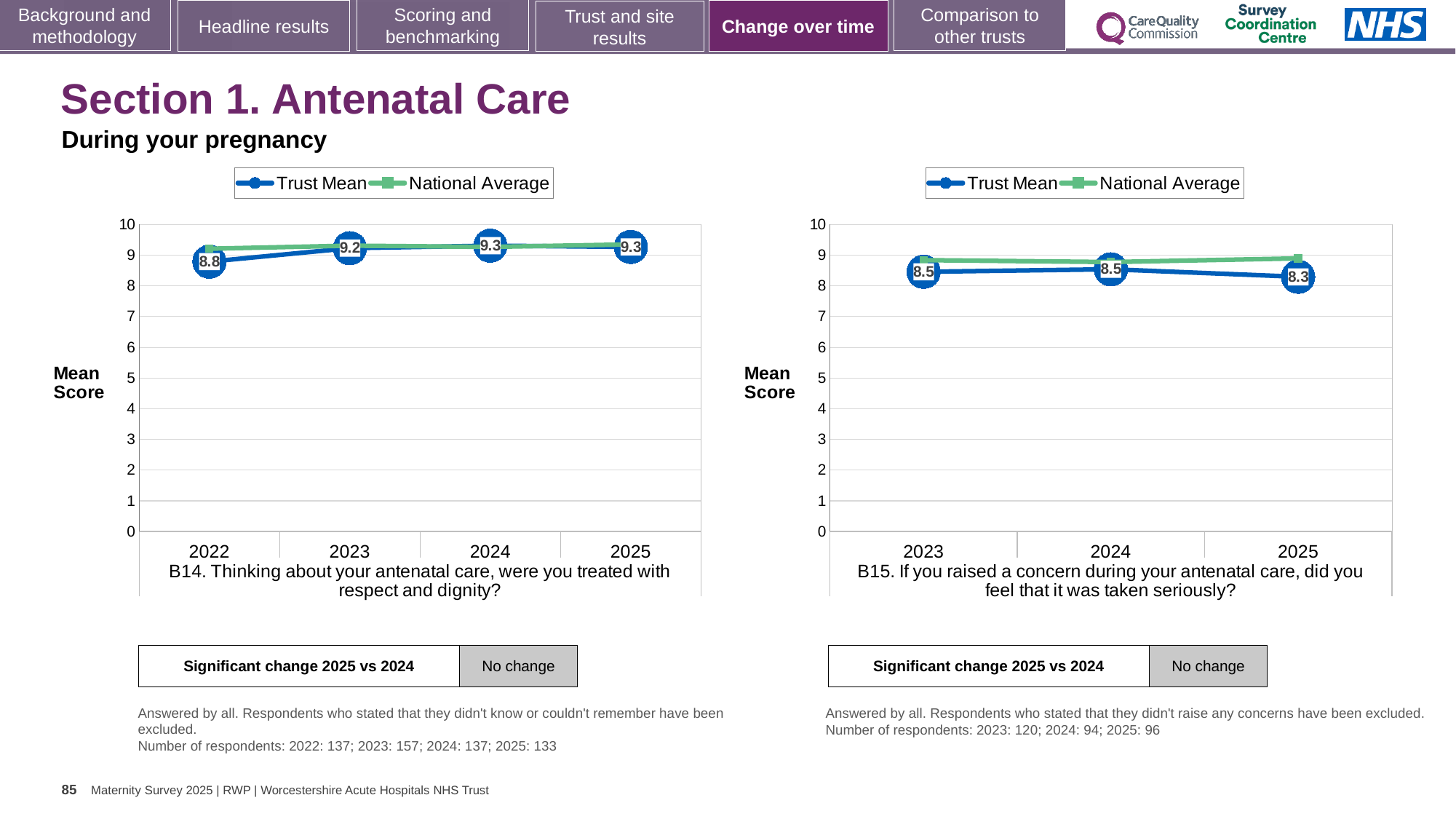
In the B14 chart (left), what is the Trust Mean for 2022? 8.8 In the B14 chart (left), what is the Trust Mean for 2025? 9.3 What kind of chart is the B14 chart (left)? Line chart In the B15 chart (right), is the Trust Mean for 2025 greater or less than 9? less In the B15 chart (right), which year has the lowest Trust Mean? 2025 In the B14 chart (left), by how much did the Trust Mean increase from 2022 to 2023? 0.4 In the B14 chart (left), which year has the lowest Trust Mean? 2022 In the B15 chart (right), what is the difference between the Trust Mean in 2024 and in 2025? 0.2 How many series does the legend of the B15 chart (right) list? 2 In the B15 chart (right), what is the Trust Mean for 2023? 8.5 How many years are plotted on the x axis of the B14 chart (left)? 4 In the B15 chart (right), what is the Trust Mean for 2025? 8.3